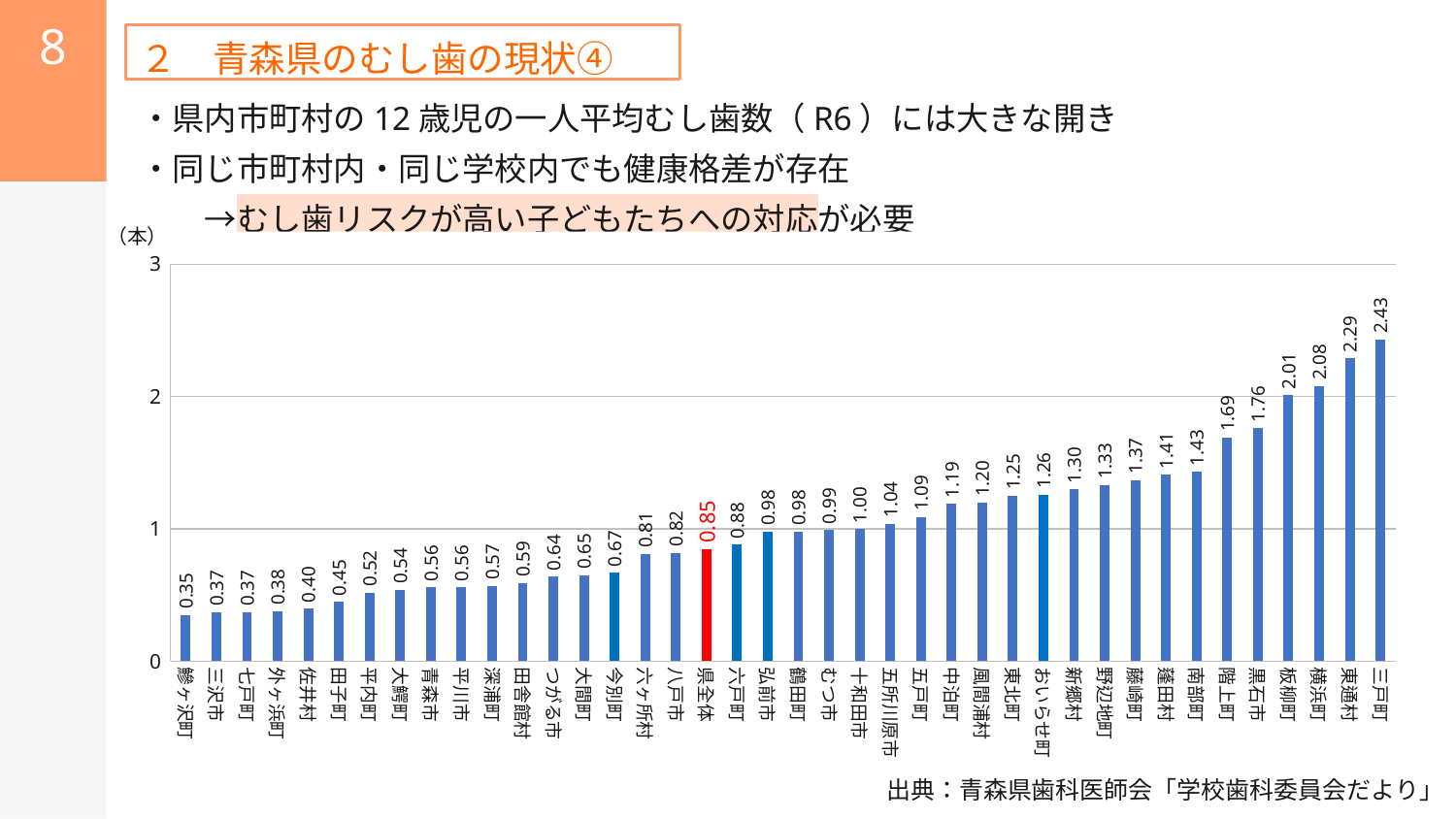
Do the values rise or fall from left to right along the x axis? rise What kind of chart is shown on the slide? bar chart What is the value for 青森市? 0.56 Which is larger, the value for 八戸市 or the value for 黒石市? 黒石市 What is the difference between the values for 三戸町 and 鰺ヶ沢町? 2.08 Is the value for 東通村 greater or less than 2? greater Which category has the lowest value? 鰺ヶ沢町 Which category has the highest value? 三戸町 What is the value for 弘前市? 0.98 How many bars are plotted in the chart? 40 What unit is shown at the top of the vertical axis? 本 What is the value for 県全体 (the red bar)? 0.85